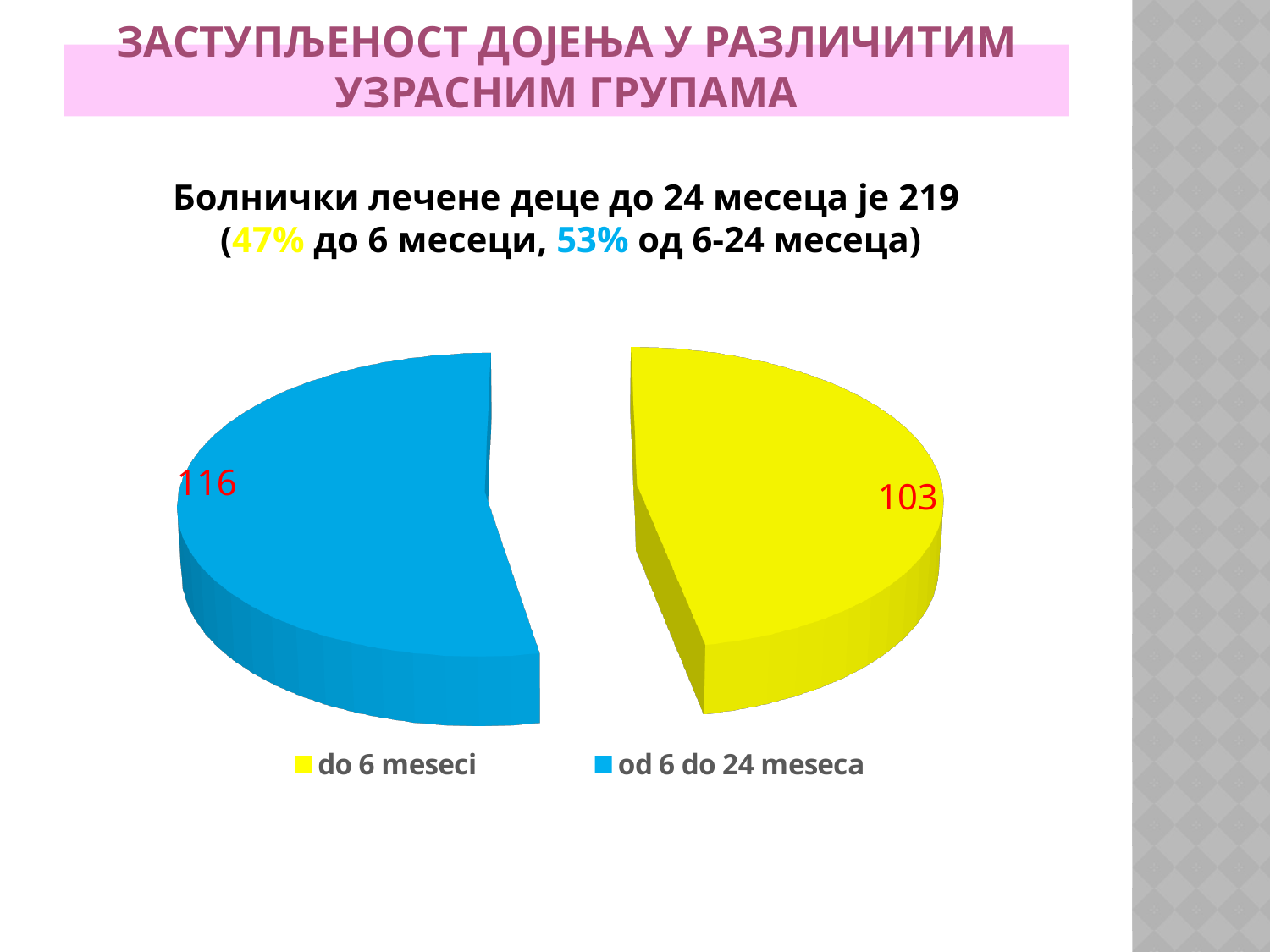
How many slices does the pie chart have? 2 How many entries does the legend list? 2 What kind of chart is shown on the slide? pie chart Which category has the largest slice? od 6 do 24 meseca What is the value for "do 6 meseci"? 103 Which category has the smallest slice? do 6 meseci What colour is the slice for "od 6 do 24 meseca"? blue Which is larger, the value for "do 6 meseci" or the value for "od 6 do 24 meseca"? od 6 do 24 meseca What is the value for "od 6 do 24 meseca"? 116 What is the difference between the values for "od 6 do 24 meseca" and "do 6 meseci"? 13 What colour is the slice for "do 6 meseci"? yellow What is the total of the two slices in the pie chart? 219